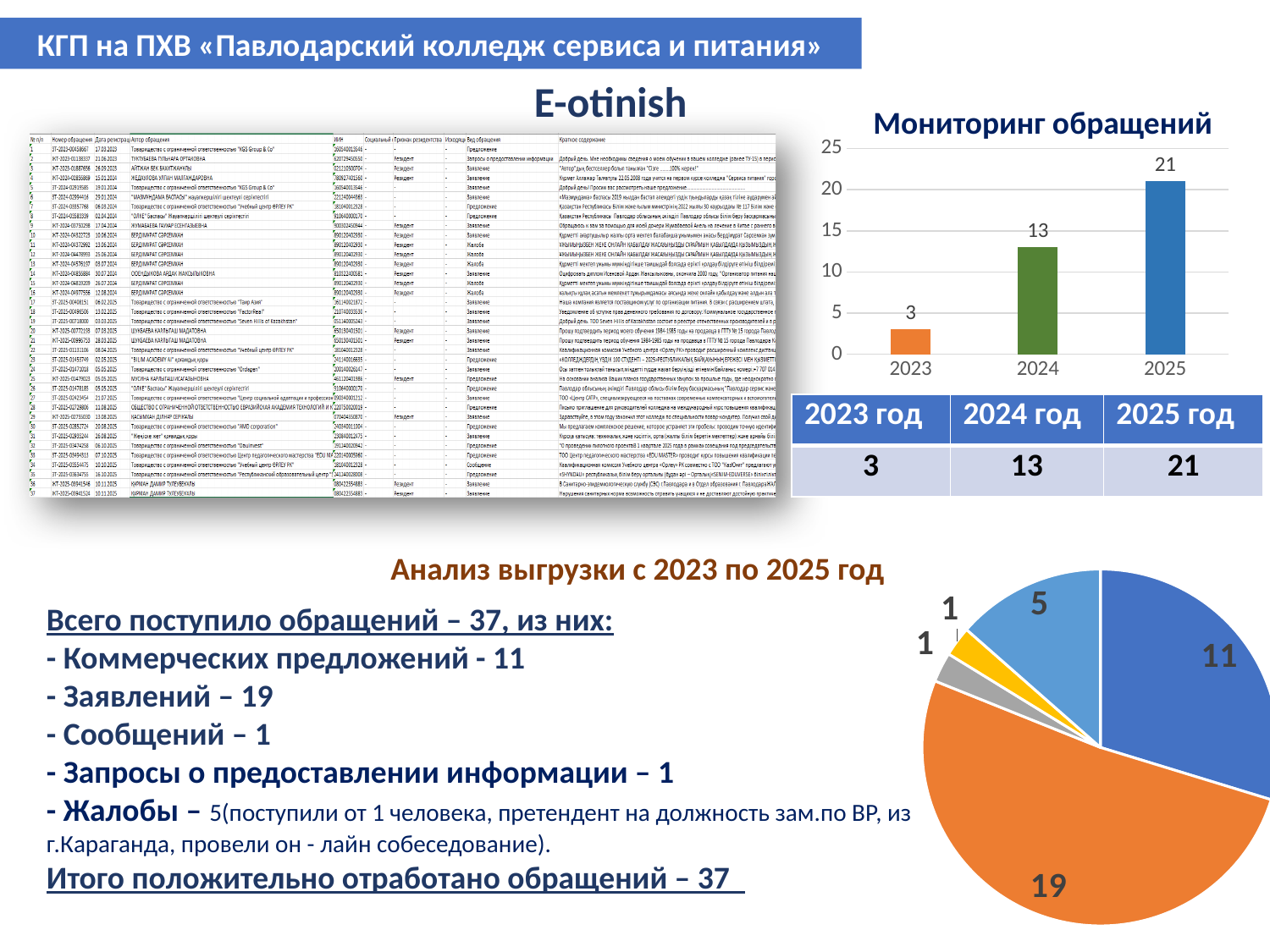
What kind of chart is 'Мониторинг обращений'? bar chart How many years are shown in the 'Мониторинг обращений' bar chart? 3 What kind of chart is shown at the bottom right of the slide? pie chart In the 'Мониторинг обращений' bar chart, which year has the highest value? 2025 In the 'Мониторинг обращений' bar chart, which is larger, the value for 2024 or the value for 2025? 2025 In the 'Мониторинг обращений' bar chart, what is the difference between the values for 2025 and 2023? 18 In the 'Мониторинг обращений' bar chart, do the values rise or fall from 2023 to 2025? rise In the pie chart at the bottom right of the slide, what is the value of the largest slice? 19 In the 'Мониторинг обращений' bar chart, what is the value for 2024? 13 In the 'Мониторинг обращений' bar chart, what is the value for 2025? 21 In the 'Мониторинг обращений' bar chart, which year has the lowest value? 2023 In the 'Мониторинг обращений' bar chart, what is the value for 2023? 3